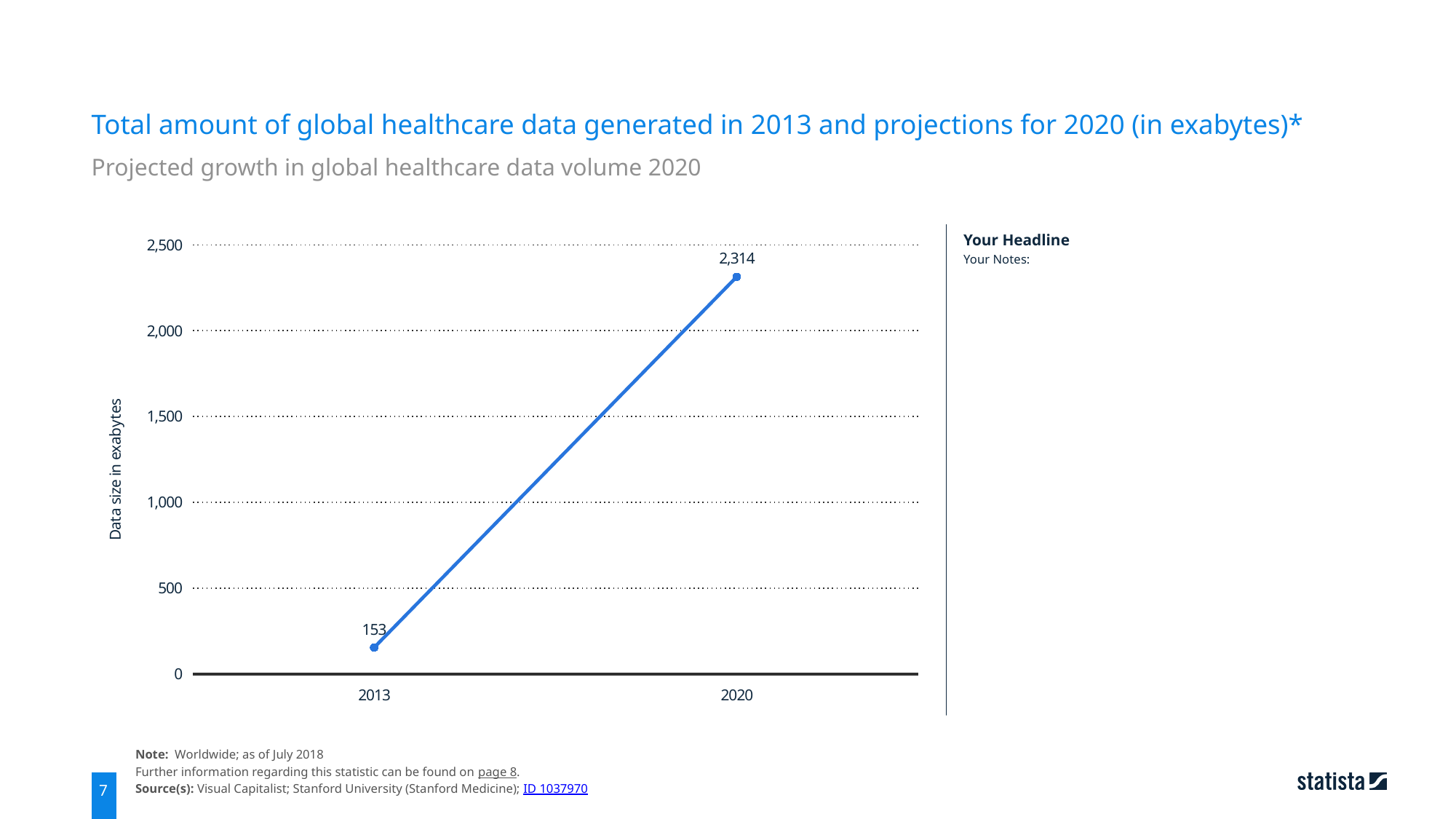
What is the subtitle of the chart? Projected growth in global healthcare data volume 2020 Which year has the lower value? 2013 What is the label of the y axis? Data size in exabytes What is the difference between the 2020 and 2013 values? 2,161 What is the projected value for 2020? 2,314 Do the values rise or fall from 2013 to 2020? rise What kind of chart is shown on the slide? line chart What is the value for 2013? 153 Which year has the higher value? 2020 Is the value for 2013 greater or less than 500? less How many data points are plotted on the chart? 2 Is the value for 2020 greater or less than 2,000? greater